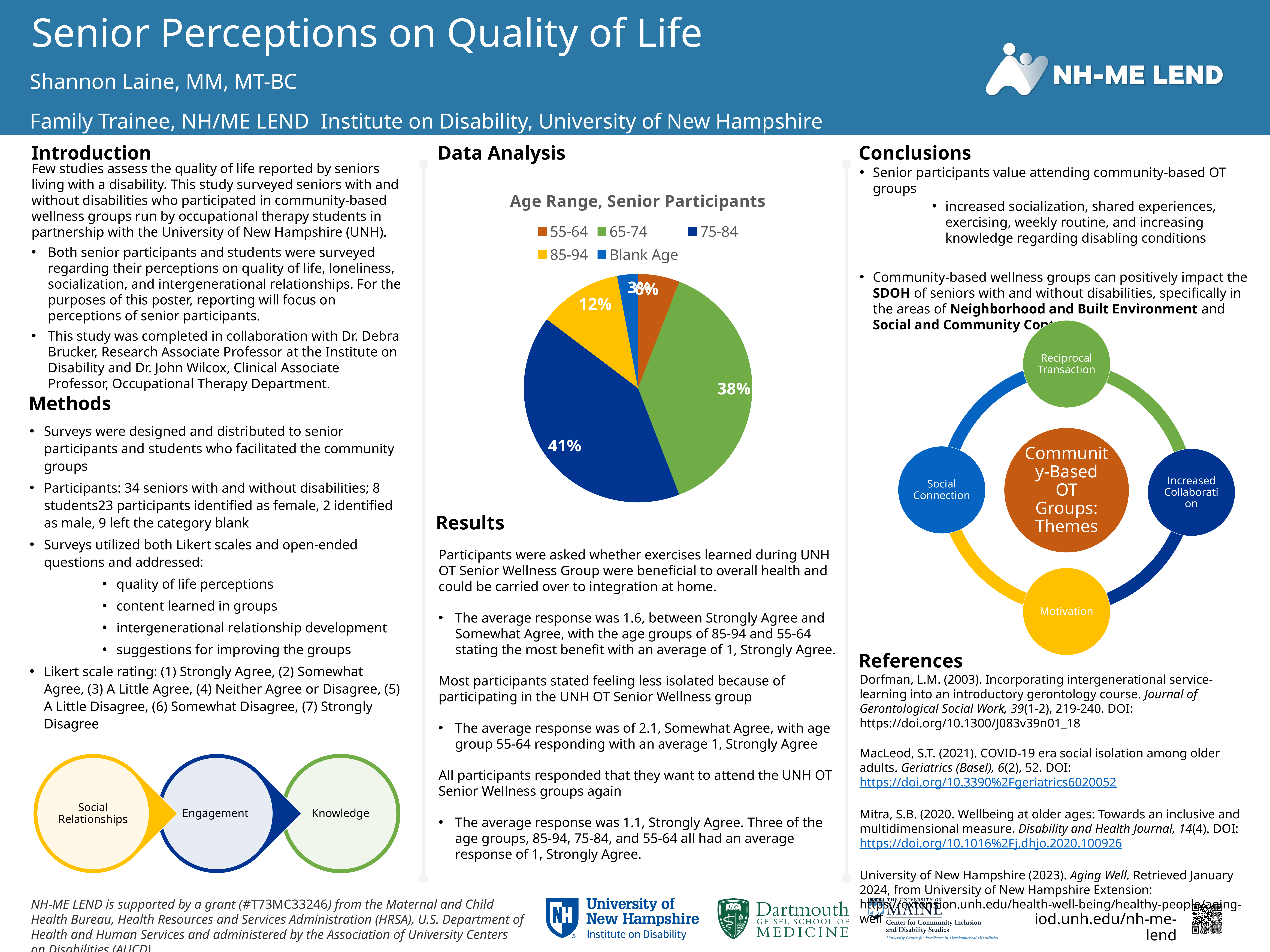
What is the title of the pie chart? Age Range, Senior Participants What is the difference in percentage points between the 75-84 and 65-74 age ranges? 3 percentage points How many age categories does the pie chart legend list? 5 Which age range has a larger share, 85-94 or 65-74? 65-74 Which age range has the largest share of senior participants? 75-84 Which age range has a larger share, 75-84 or 65-74? 75-84 What percentage of senior participants are in the 85-94 age range? 12% What percentage of senior participants are in the 65-74 age range? 38% What percentage of senior participants are in the 75-84 age range? 41% What colour represents the 65-74 age range in the pie chart? green What is the difference in percentage points between the 65-74 and 85-94 age ranges? 26 percentage points What kind of chart is shown under Data Analysis? pie chart